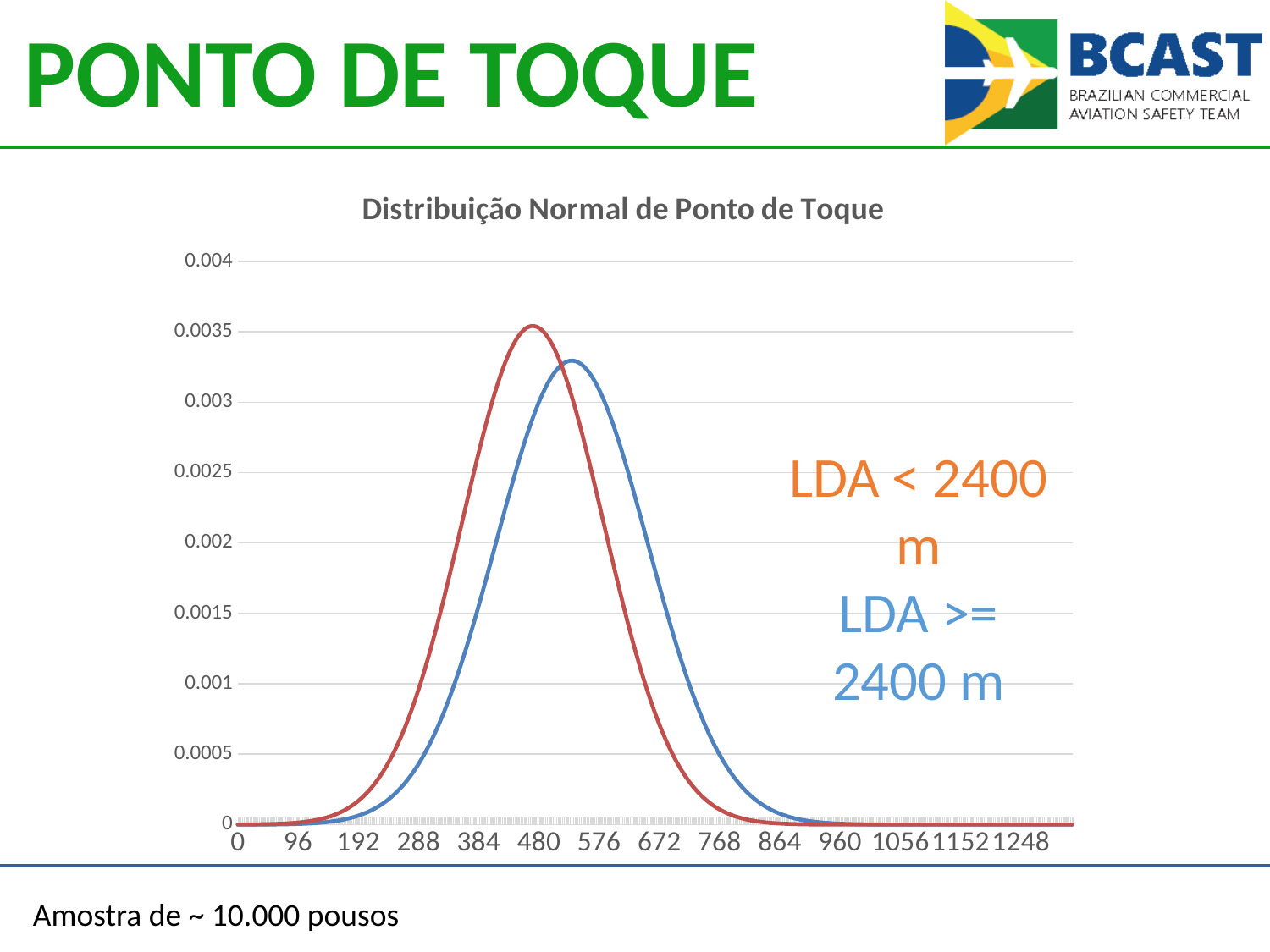
What is the title of the chart? Distribuição Normal de Ponto de Toque Which curve has its peak further to the right along the x axis? LDA >= 2400 m What kind of chart is shown on the slide? line chart Is the peak of the LDA >= 2400 m curve greater or less than 0.0035? less What is the highest value labelled on the y axis? 0.004 How many curves (series) are plotted on the chart? 2 Is the peak of the LDA < 2400 m curve greater or less than 0.003? greater Is the peak of the LDA >= 2400 m curve greater or less than 0.003? greater How many tick labels are shown on the x axis? 14 What is the largest value labelled on the x axis? 1248 Do the curves rise or fall between x = 768 and x = 960? fall Which curve reaches the higher peak, LDA < 2400 m or LDA >= 2400 m? LDA < 2400 m